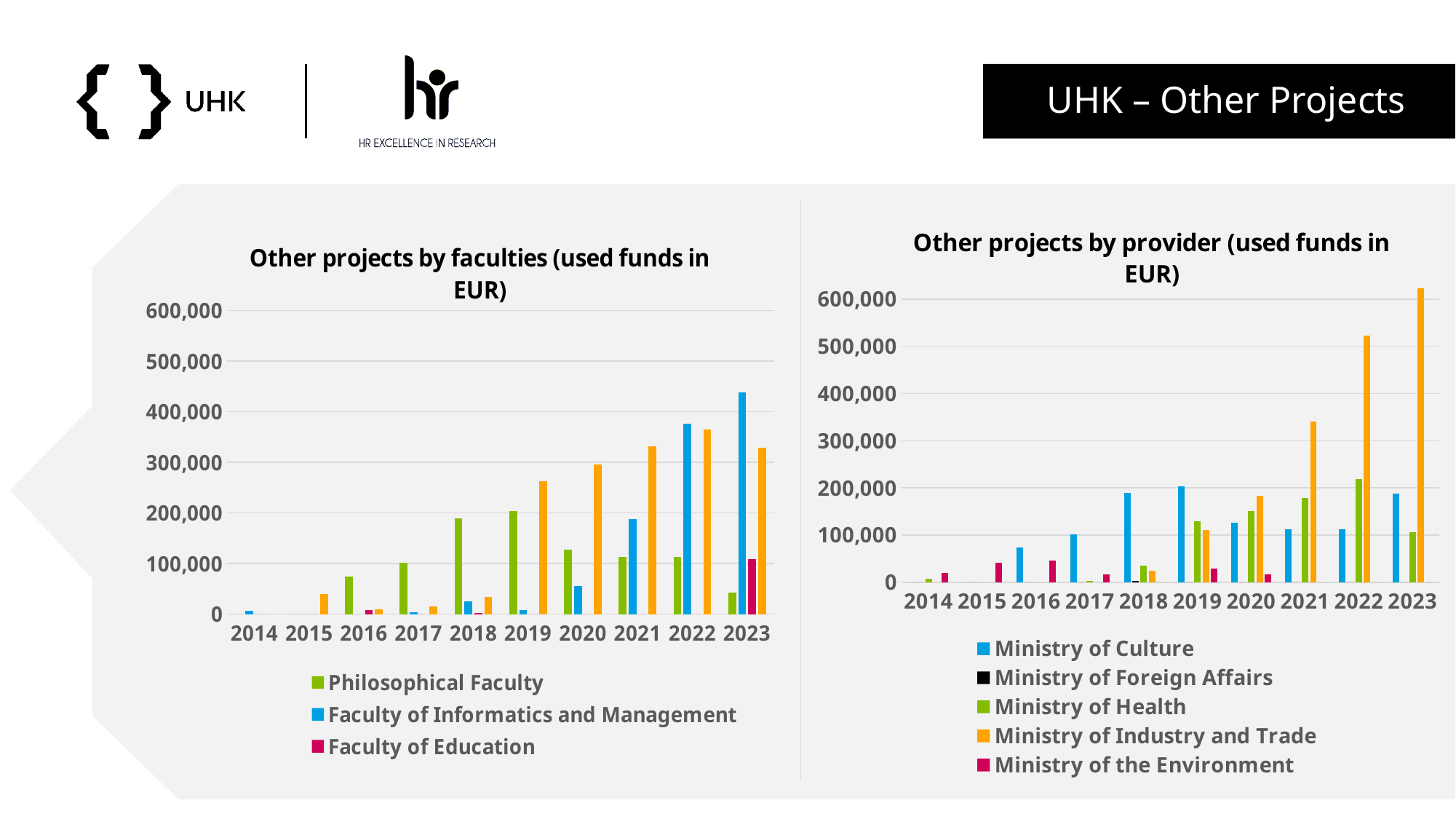
In the chart titled "Other projects by faculties (used funds in EUR)", how many years are shown on the x axis? 10 In the chart titled "Other projects by provider (used funds in EUR)", how many series does the legend list? 5 In the chart titled "Other projects by faculties (used funds in EUR)", is the value for Philosophical Faculty in 2018 greater or less than 200,000? less In the chart titled "Other projects by provider (used funds in EUR)", what colour represents Ministry of the Environment in the legend? pink/magenta In the chart titled "Other projects by provider (used funds in EUR)", is the value for Ministry of Industry and Trade in 2023 greater or less than 600,000? greater In the chart titled "Other projects by provider (used funds in EUR)", which provider has the highest bar in 2022? Ministry of Industry and Trade In the chart titled "Other projects by faculties (used funds in EUR)", is the value for Faculty of Informatics and Management in 2023 greater or less than 400,000? greater In the chart titled "Other projects by provider (used funds in EUR)", which is larger in 2019: Ministry of Culture or Ministry of Health? Ministry of Culture In the chart titled "Other projects by faculties (used funds in EUR)", what kind of chart is shown? bar chart In the chart titled "Other projects by faculties (used funds in EUR)", how many series does the legend list? 3 In the chart titled "Other projects by provider (used funds in EUR)", do the Ministry of Industry and Trade values rise or fall from 2019 to 2023? rise In the chart titled "Other projects by faculties (used funds in EUR)", in which year is the Faculty of Informatics and Management bar highest? 2023